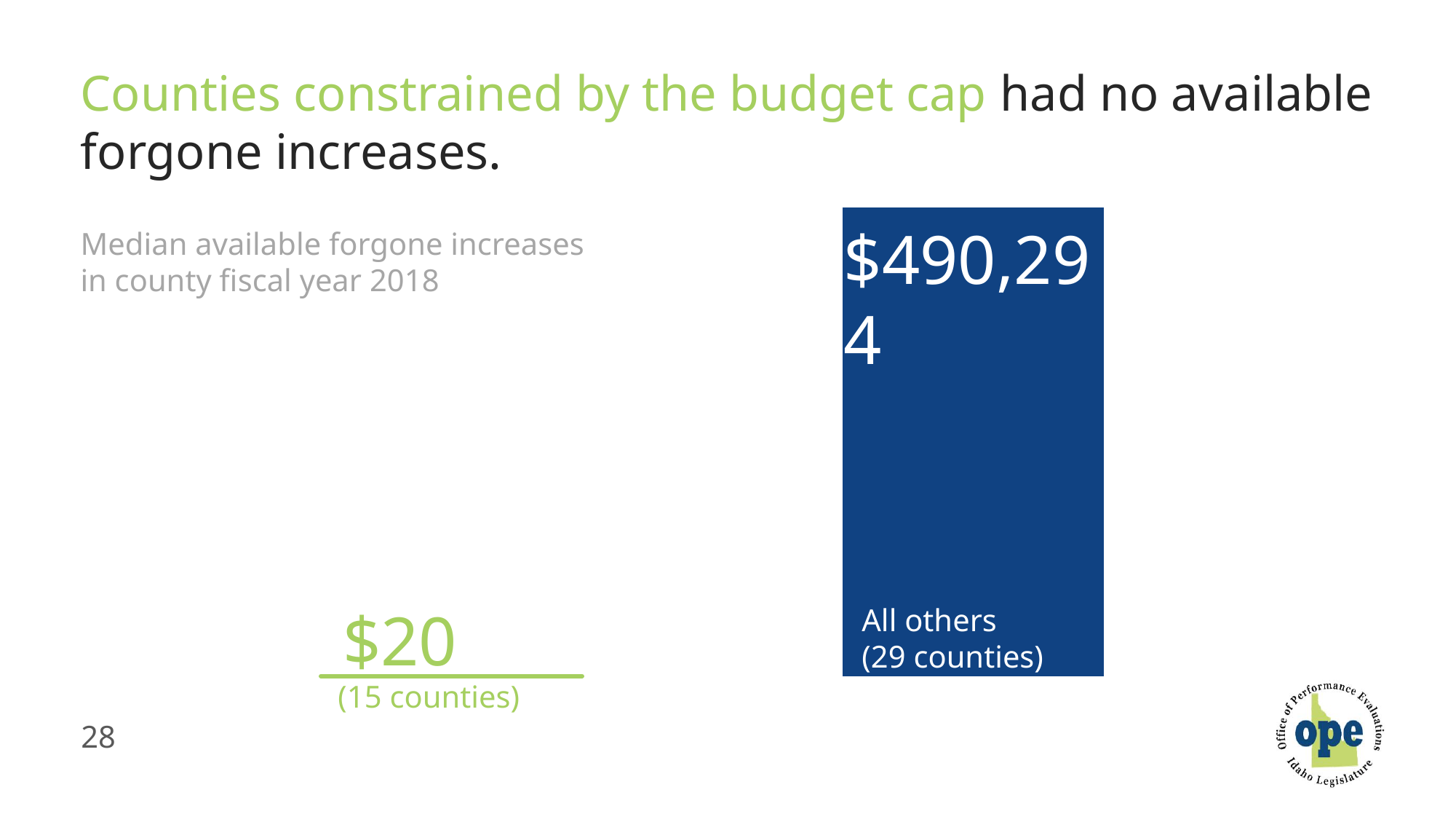
How many counties are included in the 'All others' bar? 29 Is the value for 'All others (29 counties)' larger or smaller than the value for the '(15 counties)' bar? larger How many bars are plotted on the chart? 2 Which bar shows the higher median available forgone increase, the '(15 counties)' bar or the 'All others (29 counties)' bar? All others (29 counties) What is the difference between the median available forgone increase for 'All others (29 counties)' and for the '(15 counties)' bar? $490,274 What is the median available forgone increase shown for the 'All others (29 counties)' bar? $490,294 What is the median available forgone increase shown for the bar labelled '(15 counties)'? $20 Which bar shows the lowest median available forgone increase? (15 counties) What fiscal year does the chart subtitle say the median available forgone increases are for? county fiscal year 2018 What kind of chart is shown on the slide? bar chart